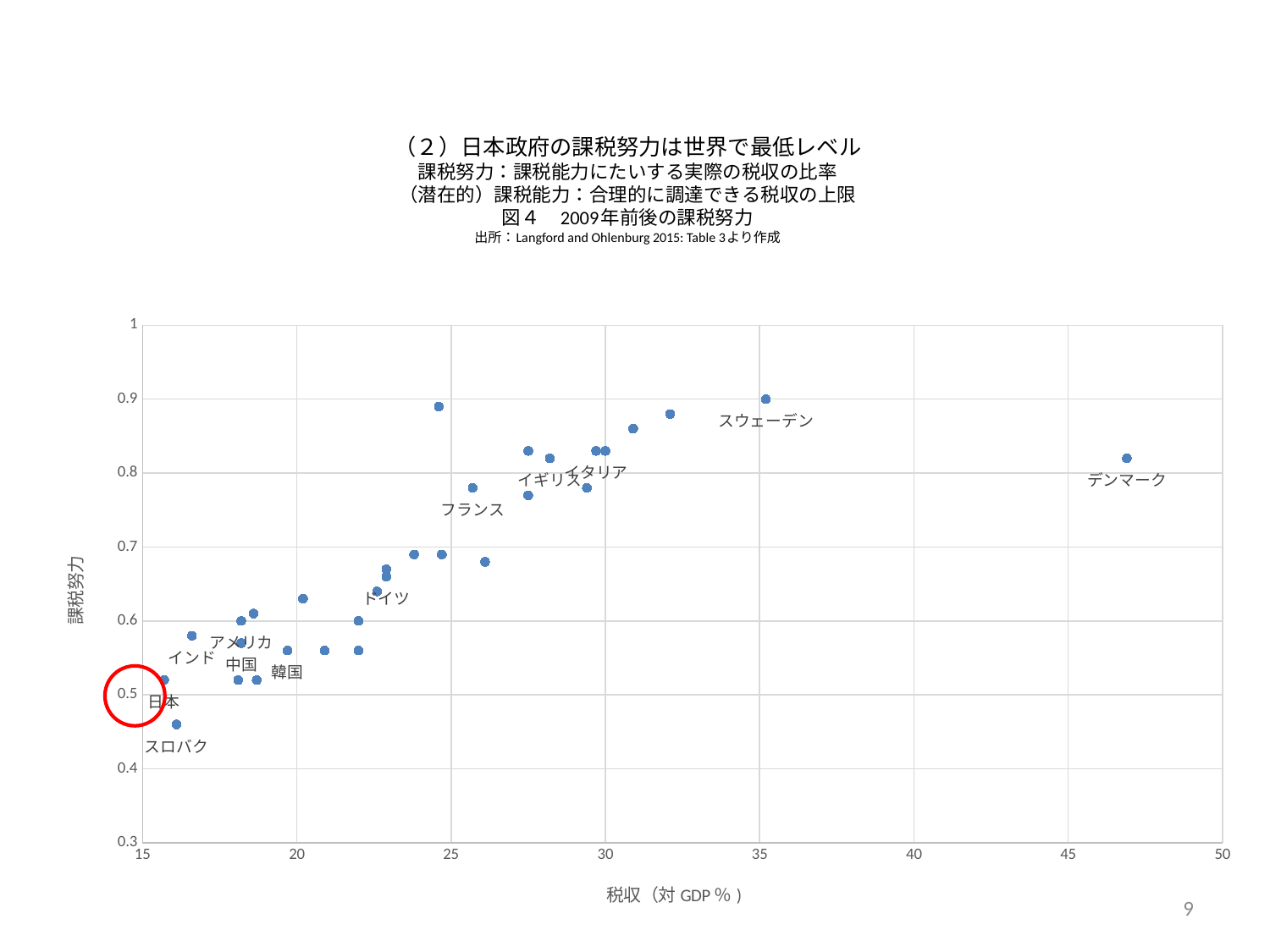
Is the 税収（対GDP%）value for デンマーク greater or less than 45? greater How many countries are labeled by name on the chart? 12 Among the labeled countries, which has the highest 税収（対GDP%）? デンマーク Is the 課税努力 value for スロバク greater or less than 0.5? less Is the 課税努力 value for 日本 greater or less than 0.6? less What kind of chart is shown on the slide? scatter chart Among the labeled countries, which has the lowest 課税努力? スロバク What is the title of the chart (図４)? 2009年前後の課税努力 Which has the higher 課税努力, スウェーデン or 日本? スウェーデン As 税収（対GDP%）increases along the x axis, does 課税努力 generally rise or fall? rise Which country's point is circled in red on the chart? 日本